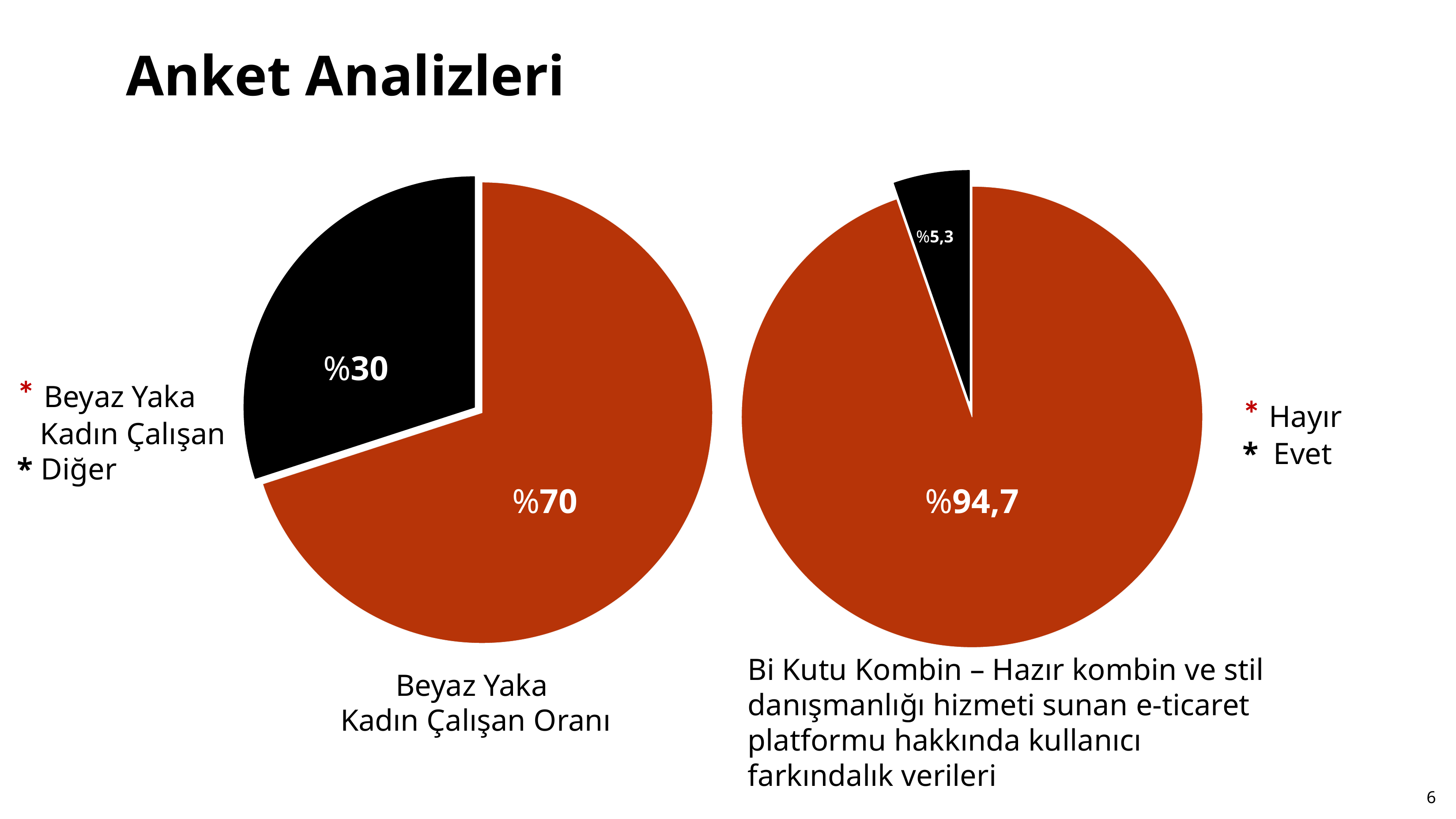
In the right pie chart (Bi Kutu Kombin awareness data), what share is labelled for Hayır? %94,7 What type of chart is used for the Bi Kutu Kombin awareness data on the right? Pie chart In the right pie chart (Bi Kutu Kombin awareness data), what share is labelled for Evet? %5,3 In the right pie chart (Bi Kutu Kombin awareness data), what colour is the Evet slice? Black In the left pie chart (Beyaz Yaka Kadın Çalışan Oranı), what share is labelled for the Beyaz Yaka Kadın Çalışan slice? %70 In the right pie chart (Bi Kutu Kombin awareness data), which is larger, Hayır or Evet? Hayır In the left pie chart (Beyaz Yaka Kadın Çalışan Oranı), which slice is the largest? Beyaz Yaka Kadın Çalışan In the left pie chart (Beyaz Yaka Kadın Çalışan Oranı), what share is labelled for the Diğer slice? %30 In the left pie chart (Beyaz Yaka Kadın Çalışan Oranı), what is the difference in percentage points between the Beyaz Yaka Kadın Çalışan slice and the Diğer slice? 40 In the right pie chart (Bi Kutu Kombin awareness data), which slice is the smallest? Evet How many slices does the left pie chart (Beyaz Yaka Kadın Çalışan Oranı) have? 2 In the right pie chart (Bi Kutu Kombin awareness data), what is the difference in percentage points between Hayır and Evet? 89,4